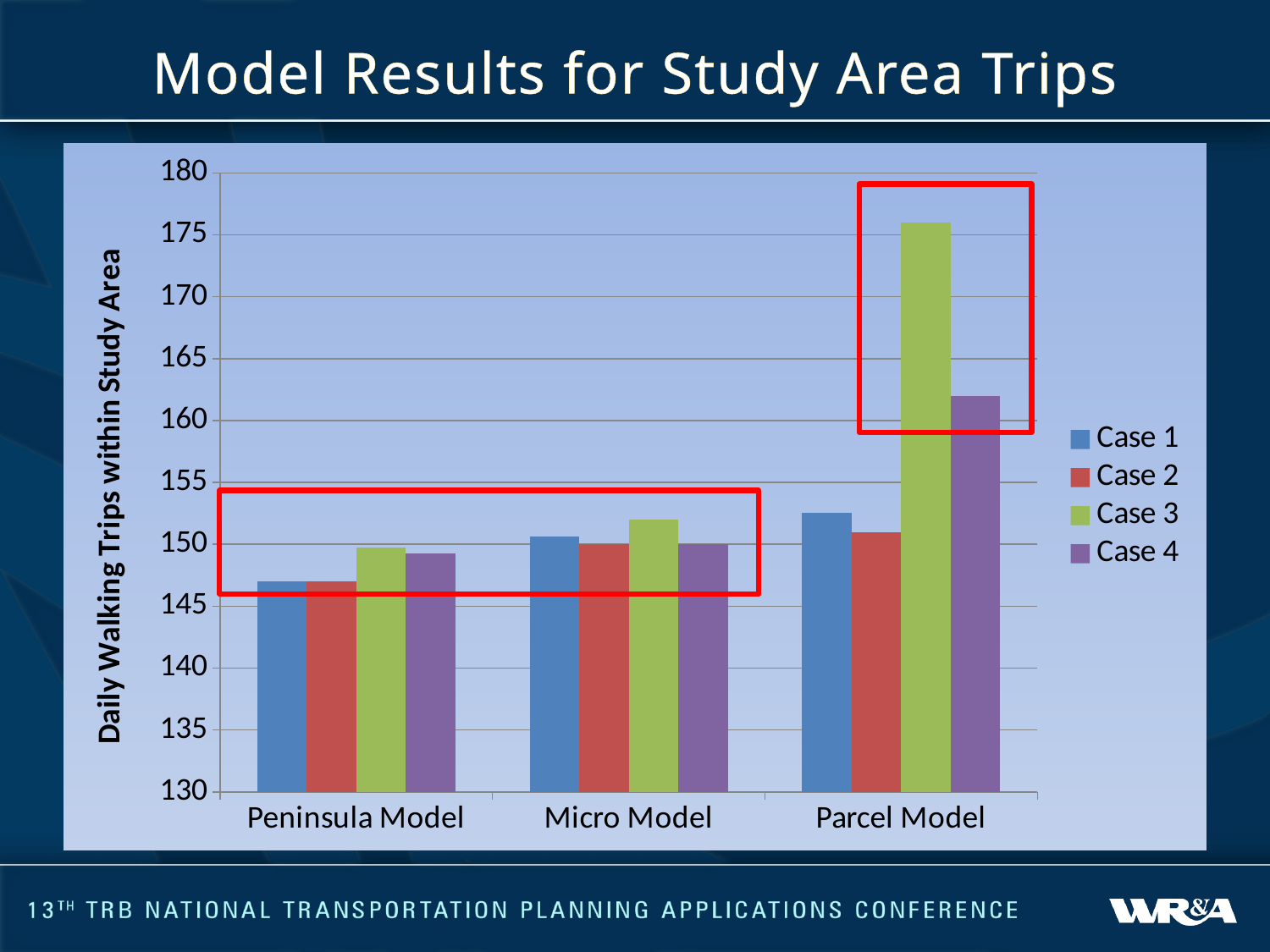
Which model has the lowest Case 1 value? Peninsula Model Is the Case 4 value for Parcel Model greater or less than 160? greater Which model has the highest Case 3 value? Parcel Model Is the Case 3 value for Micro Model greater or less than 155? less How many series does the legend list? 4 Is the Case 1 value for Peninsula Model greater or less than 150? less Which is larger for Peninsula Model, the Case 1 value or the Case 3 value? Case 3 What is the label on the vertical axis of the chart? Daily Walking Trips within Study Area How many model categories are shown on the x axis? 3 What kind of chart is shown on the slide? bar chart Which is larger for Parcel Model, the Case 3 value or the Case 4 value? Case 3